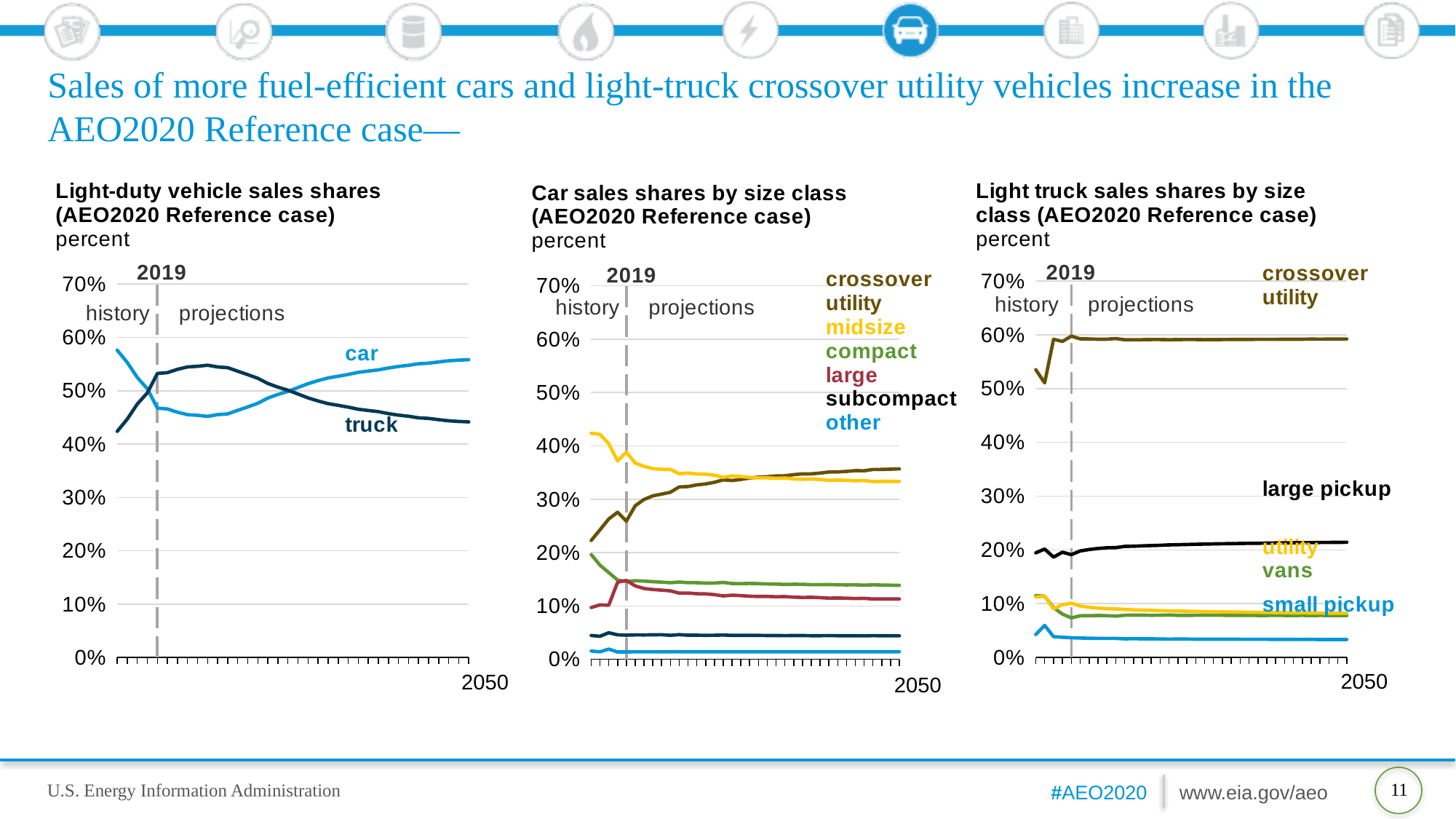
In the 'Light-duty vehicle sales shares' chart, how many series are labelled? 2 In the 'Car sales shares by size class' chart, how many series does the legend list? 6 In the 'Light-duty vehicle sales shares' chart, is the value for car in 2050 greater or less than 50%? greater In the 'Light-duty vehicle sales shares' chart, is the value for truck in 2050 greater or less than 50%? less In the 'Light truck sales shares by size class' chart, which series has the highest share in 2050? crossover utility In the 'Car sales shares by size class' chart, does the midsize share rise or fall over the projection period? fall In the 'Light truck sales shares by size class' chart, is the value for crossover utility in 2050 greater or less than 50%? greater In the 'Light truck sales shares by size class' chart, how many series are labelled? 5 In the 'Car sales shares by size class' chart, does the crossover utility share rise or fall from the start of the chart to 2050? rise In the 'Light-duty vehicle sales shares' chart, which series has the larger share in 2050, car or truck? car What kind of chart is the 'Light-duty vehicle sales shares' chart on the left? line chart In the 'Light truck sales shares by size class' chart, which series has the lowest share in 2050? small pickup